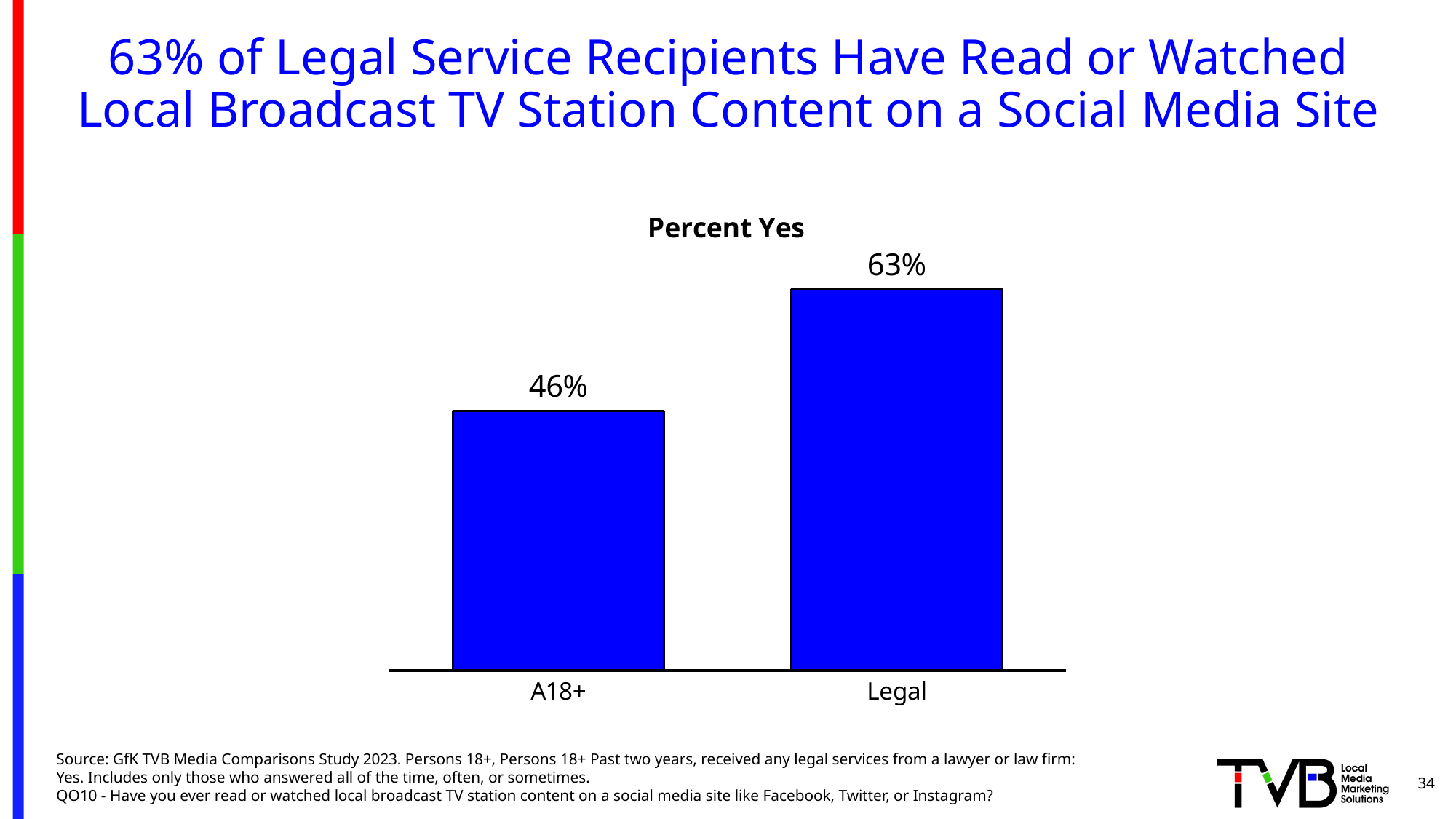
What is the Percent Yes value for A18+? 46% What is the Percent Yes value for Legal? 63% What kind of chart is shown on the slide? Bar chart What colour are the bars in the chart? Blue What is the difference in Percent Yes between Legal and A18+? 17% Which is larger, the Percent Yes value for A18+ or for Legal? Legal What is the title of the chart? Percent Yes How many categories are shown on the chart? 2 Which category has the highest Percent Yes value? Legal Which category has the lowest Percent Yes value? A18+